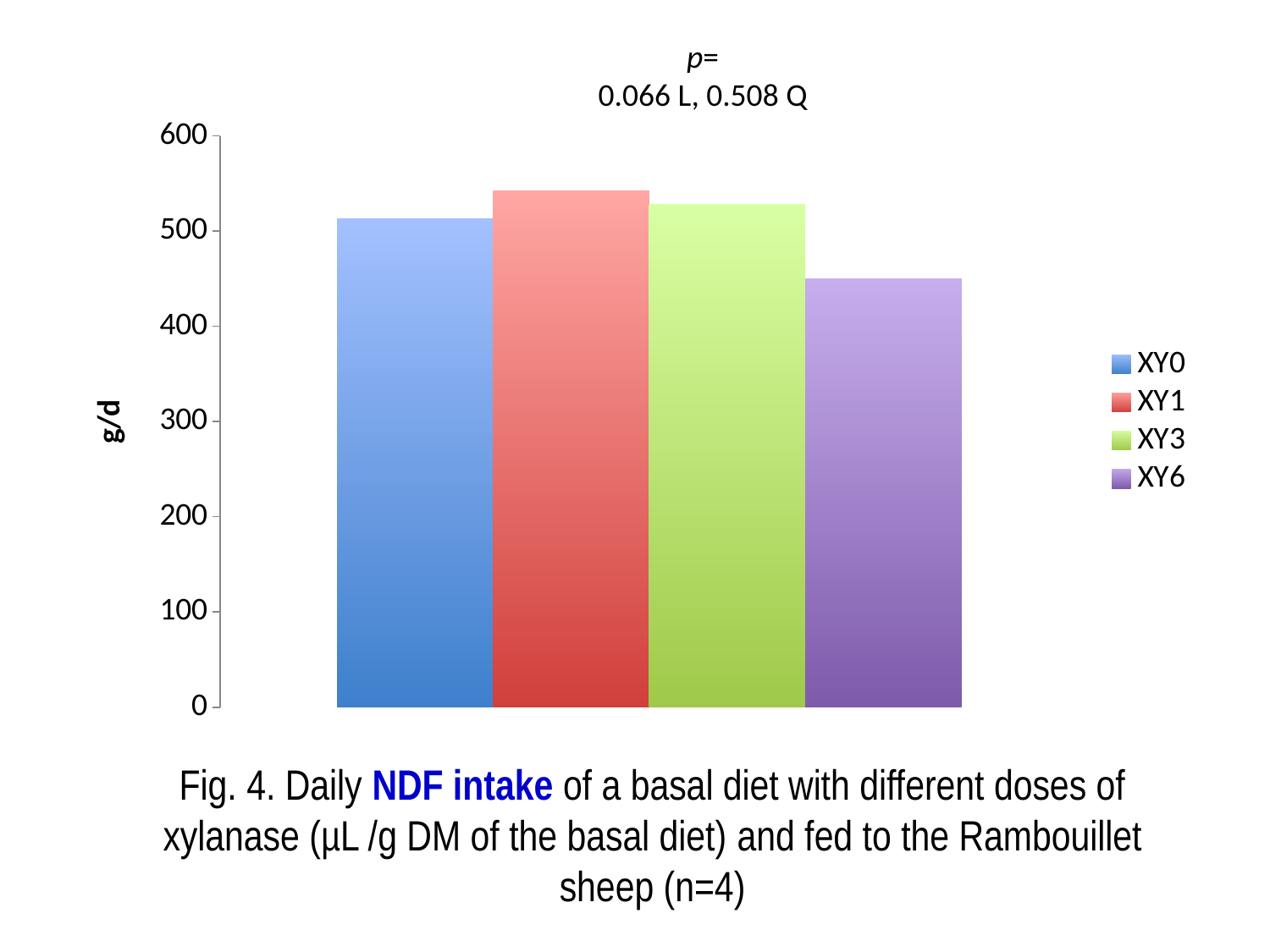
What p-values are shown in the chart title? 0.066 L, 0.508 Q Is the value for XY6 greater or less than 400? greater Is the value for XY6 greater or less than 500? less How many entries does the legend list? 4 Is the value for XY3 greater or less than 500? greater Which treatment has the lowest daily NDF intake? XY6 Which is larger, the value for XY0 or the value for XY6? XY0 How many bars are plotted in the chart? 4 Which treatment has the highest daily NDF intake? XY1 What kind of chart is shown on the slide? bar chart What is the label on the vertical axis of the chart? g/d